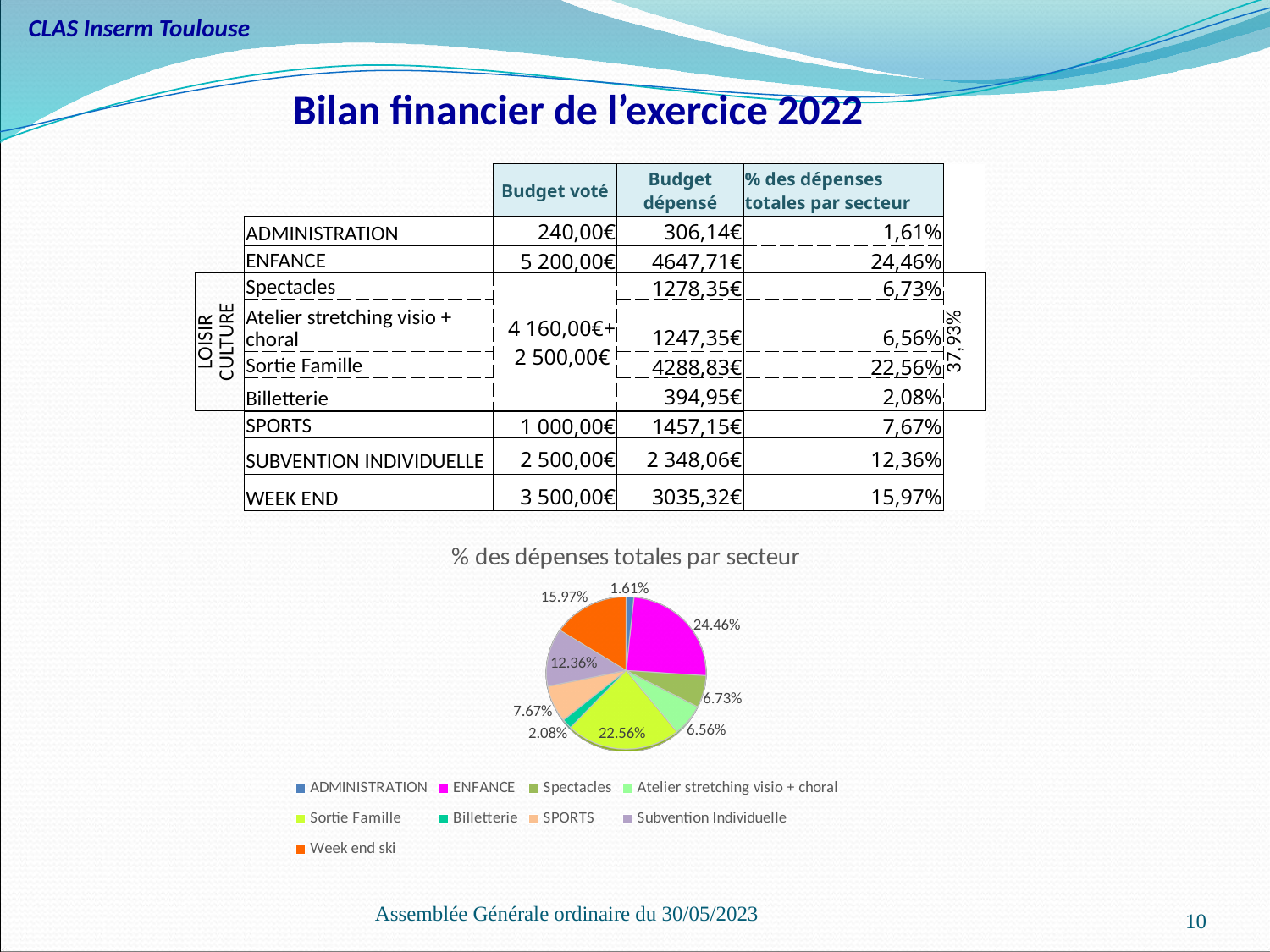
What share of the pie does Sortie Famille represent? 22.56% What is the title of the pie chart? % des dépenses totales par secteur What is the difference in percentage points between the ENFANCE slice and the Sortie Famille slice? 1.90 What share of the pie does ENFANCE represent? 24.46% Which category has the smallest slice of the pie? ADMINISTRATION How many slices does the pie chart have? 9 Which slice is larger, SPORTS or Billetterie? SPORTS Which category has the largest slice of the pie? ENFANCE What share of the pie does Week end ski represent? 15.97% Which legend entry is shown in magenta? ENFANCE What kind of chart is shown on the slide? pie chart